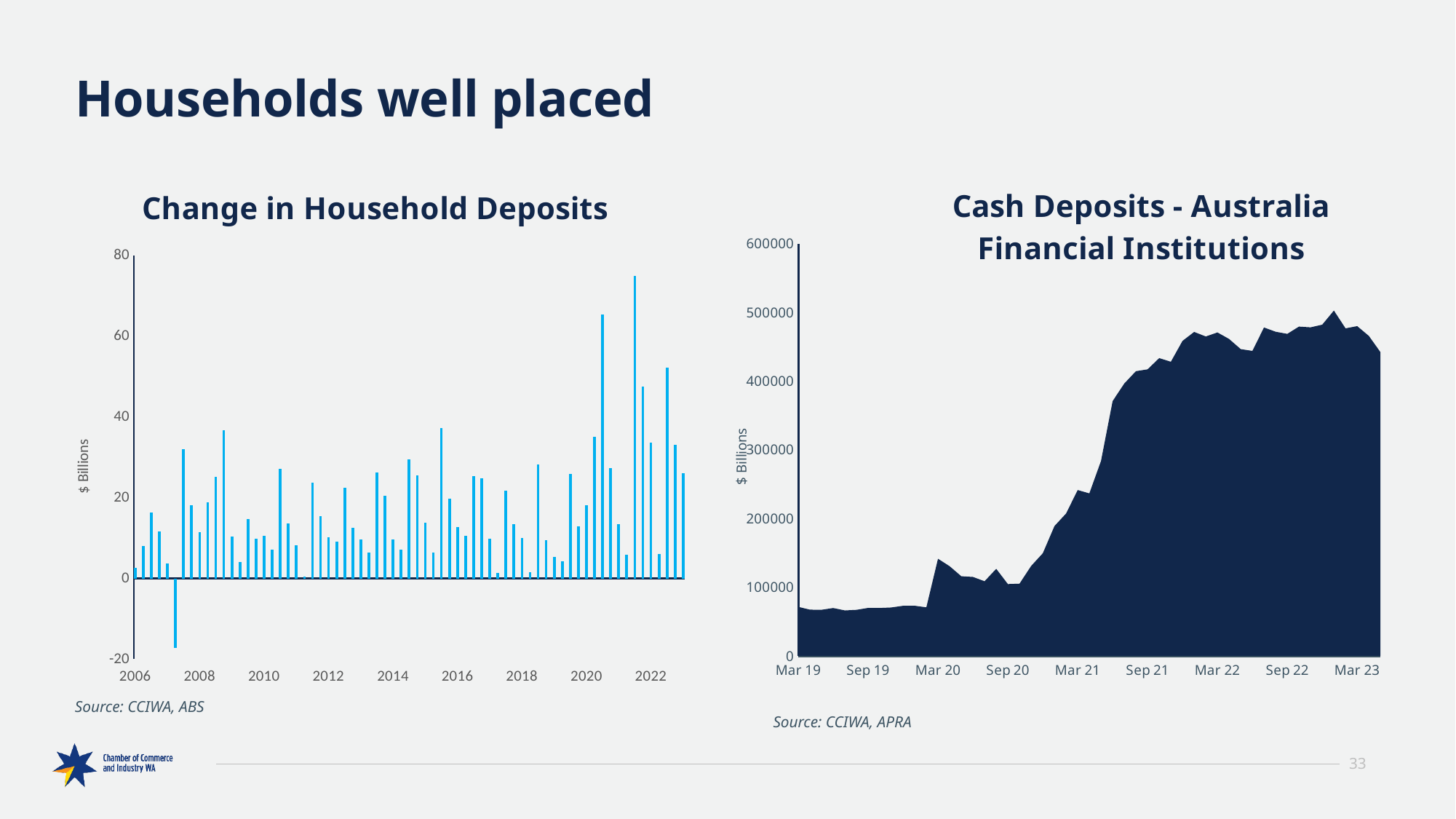
In the 'Cash Deposits - Australia Financial Institutions' chart, which is larger, the value at Mar 21 or the value at Sep 21? Sep 21 What kind of chart is the 'Cash Deposits - Australia Financial Institutions' chart? area chart In the 'Change in Household Deposits' chart, is the bar in 2007 that falls below the axis greater or less than 0? less How many x-axis tick labels are shown on the 'Cash Deposits - Australia Financial Institutions' chart? 9 In the 'Cash Deposits - Australia Financial Institutions' chart, is the value at Mar 23 greater or less than 400000? greater What is the y-axis label on the 'Change in Household Deposits' chart? $ Billions In the 'Cash Deposits - Australia Financial Institutions' chart, do values overall rise or fall from Mar 19 to Mar 23? rise In the 'Cash Deposits - Australia Financial Institutions' chart, is the value at Mar 19 greater or less than 100000? less What kind of chart is the 'Change in Household Deposits' chart? bar chart What is the highest value shown on the y-axis of the 'Cash Deposits - Australia Financial Institutions' chart? 600000